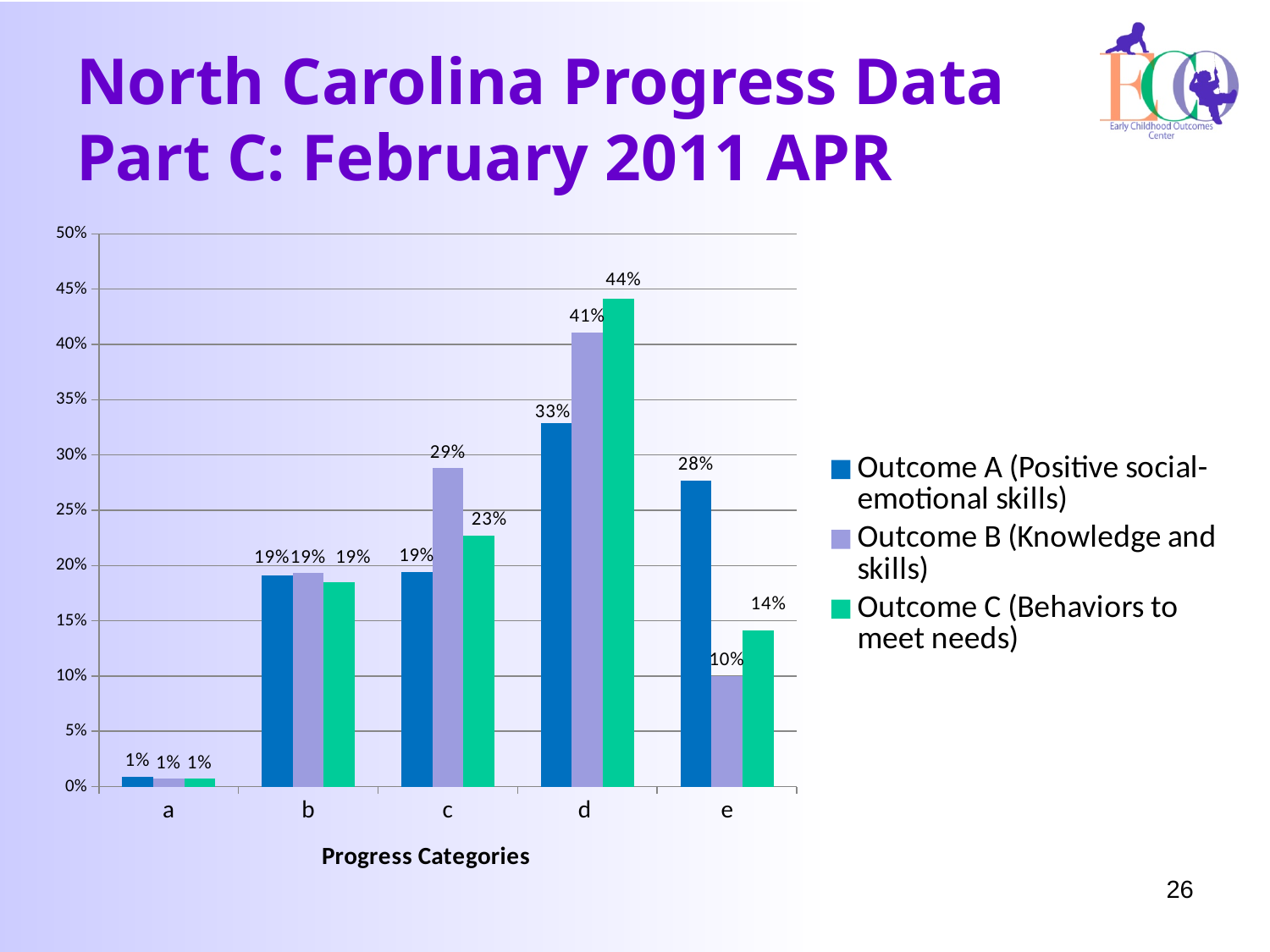
What is the x-axis title of the chart? Progress Categories What kind of chart is shown on the slide? Bar chart How many series does the legend list? 3 Is the value for Outcome B in progress category d greater or less than 40%? greater What is the difference between the Outcome C and Outcome A values in progress category d? 11% What is the value for Outcome A (Positive social-emotional skills) in progress category e? 28% How many progress categories are shown on the x axis? 5 Which progress category has the highest value for Outcome B (Knowledge and skills)? d In progress category e, which is larger: the value for Outcome A or the value for Outcome B? Outcome A What is the value for Outcome C (Behaviors to meet needs) in progress category d? 44% What is the value for Outcome B (Knowledge and skills) in progress category c? 29% Which progress category has the lowest value for Outcome C (Behaviors to meet needs)? a